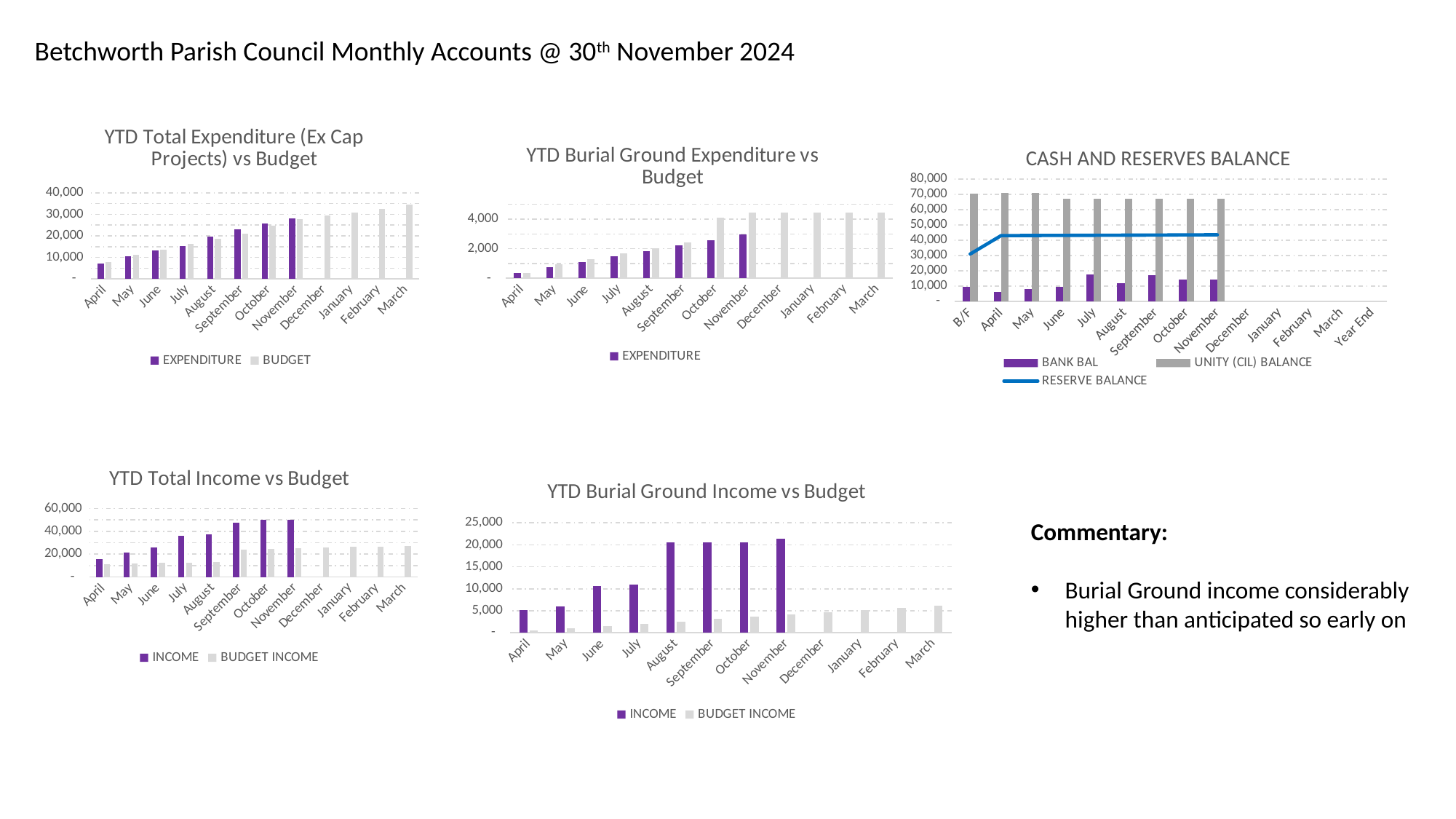
In the 'YTD Burial Ground Expenditure vs Budget' chart, how many entries does the legend list? 1 What kind of chart is the 'YTD Total Expenditure (Ex Cap Projects) vs Budget' chart? Bar chart In the 'CASH AND RESERVES BALANCE' chart, is the UNITY (CIL) BALANCE value for B/F greater or less than 60,000? greater How many months are shown on the x axis of the 'YTD Burial Ground Expenditure vs Budget' chart? 12 In the 'YTD Total Expenditure (Ex Cap Projects) vs Budget' chart, how many series does the legend list? 2 In the 'YTD Total Income vs Budget' chart, which is larger for November: INCOME or BUDGET INCOME? INCOME In the 'YTD Burial Ground Expenditure vs Budget' chart, is the EXPENDITURE value for November greater or less than 4,000? less In the 'CASH AND RESERVES BALANCE' chart, how many series does the legend list? 3 In the 'YTD Total Expenditure (Ex Cap Projects) vs Budget' chart, is the EXPENDITURE value for November greater or less than 20,000? greater In the 'CASH AND RESERVES BALANCE' chart, which series is drawn as a line? RESERVE BALANCE In the 'YTD Total Expenditure (Ex Cap Projects) vs Budget' chart, do the EXPENDITURE values rise or fall from April to November? rise